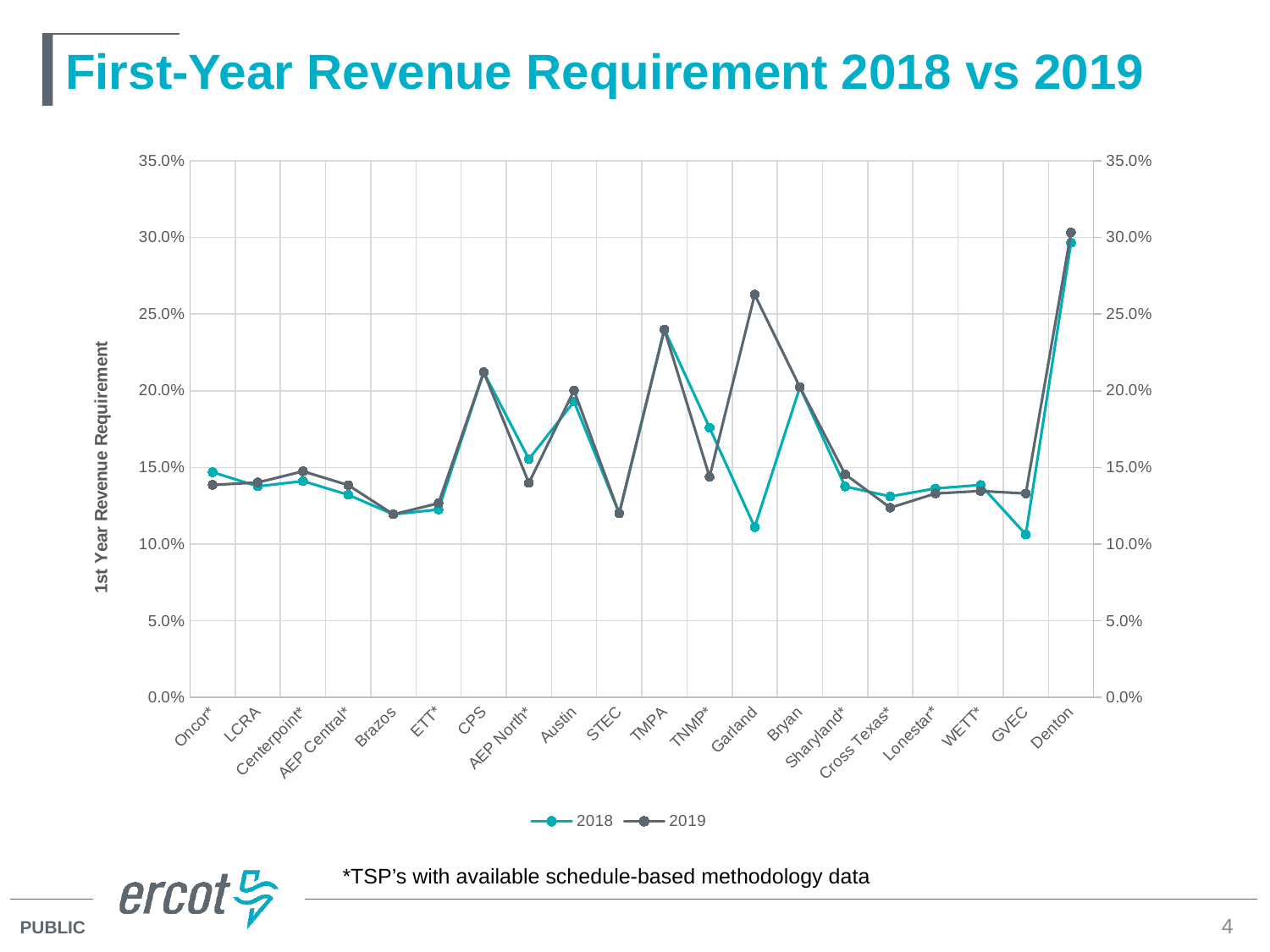
How many series does the legend list? 2 Is the 2019 value for Garland greater or less than 25.0%? greater For Garland, which series has the larger value, 2018 or 2019? 2019 Which category has the highest 2018 value? Denton Is the 2018 value for CPS greater or less than 20.0%? greater For TNMP*, which series has the larger value, 2018 or 2019? 2018 How many categories are plotted along the x axis? 20 Which category has the highest 2019 value? Denton Is the 2018 value for Garland greater or less than 15.0%? less What is the title of the chart? First-Year Revenue Requirement 2018 vs 2019 What kind of chart is shown on the slide? line chart